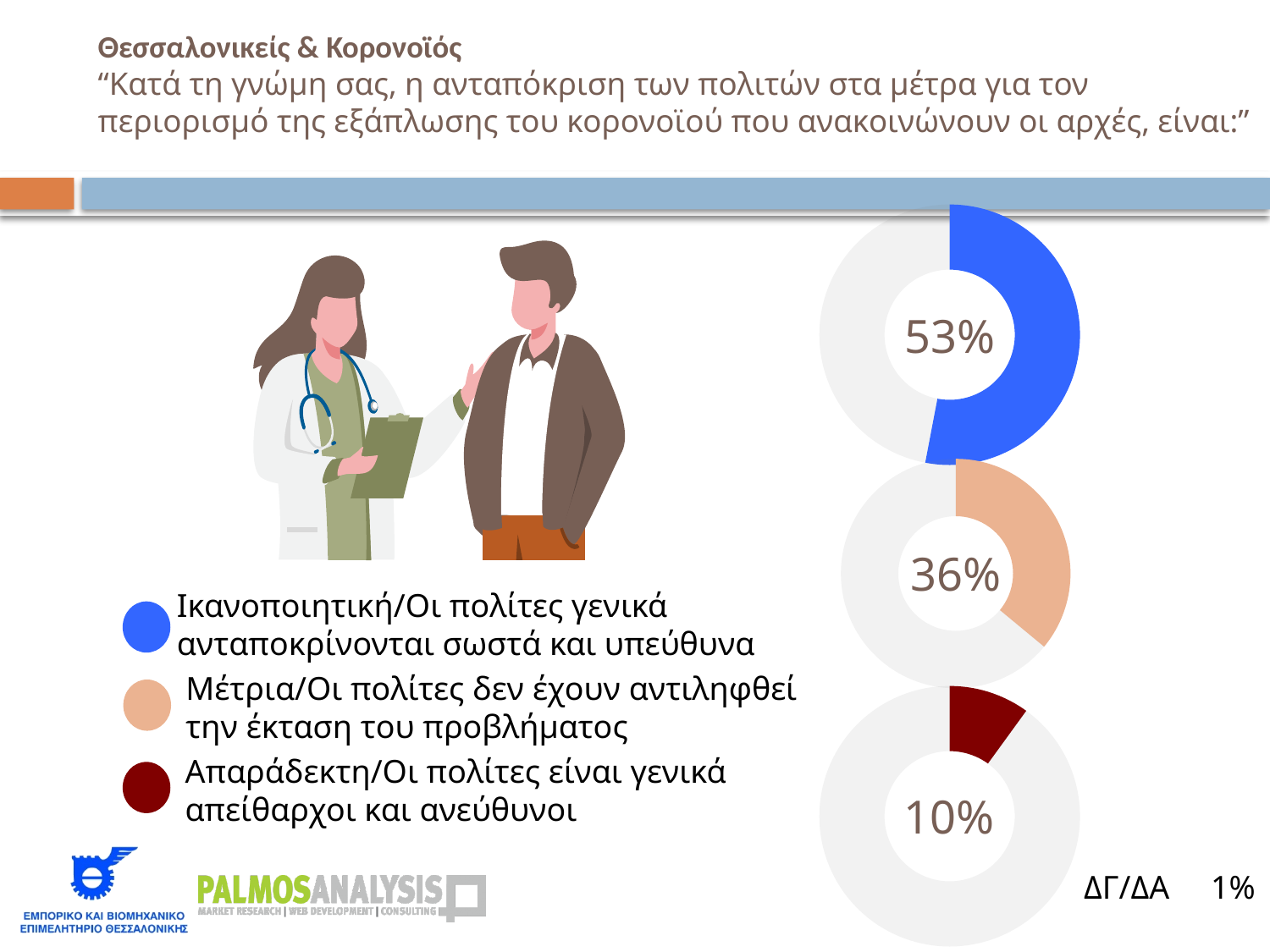
What percentage of respondents answered "Απαράδεκτη" (citizens are generally undisciplined and irresponsible)? 10% What percentage of respondents answered "Μέτρια" (citizens have not grasped the extent of the problem)? 36% What is the difference in percentage points between the "Ικανοποιητική" and "Μέτρια" responses? 17 How many response categories are listed in the legend? 3 What percentage of respondents answered "Ικανοποιητική" (citizens generally respond correctly and responsibly)? 53% What is the difference in percentage points between the "Μέτρια" and "Απαράδεκτη" responses? 26 Which response category has the highest percentage? Ικανοποιητική Which is larger, the percentage for "Μέτρια" or for "Απαράδεκτη"? Μέτρια What colour represents the "Απαράδεκτη" category? Dark red What type of chart is used to display the percentages on the slide? Donut (pie) chart Which of the three legend categories has the lowest percentage? Απαράδεκτη What percentage is shown for ΔΓ/ΔΑ (don't know / no answer)? 1%